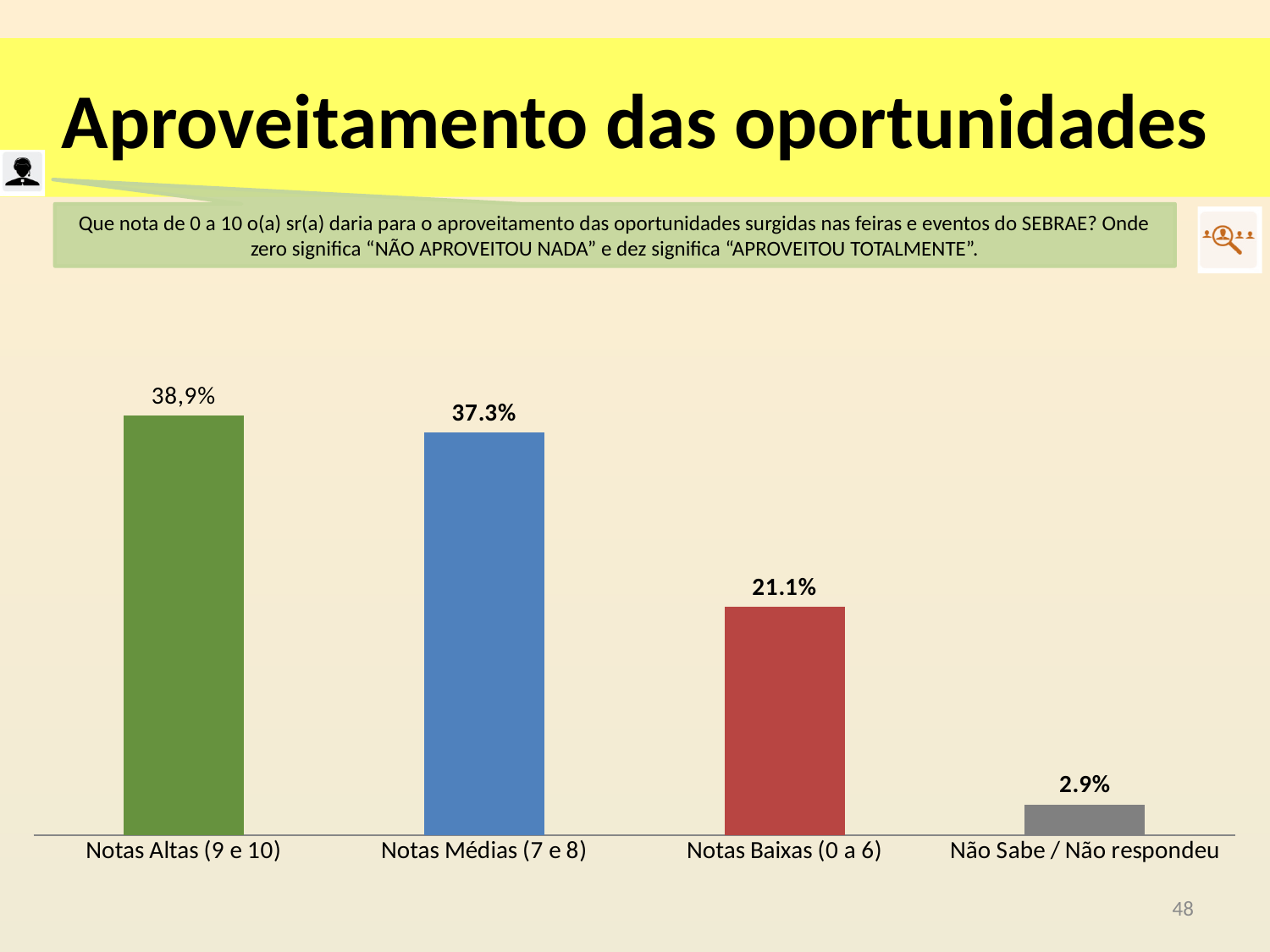
How many categories are shown in the chart? 4 What kind of chart is shown on the slide? Bar chart Which is larger, the value for Notas Altas (9 e 10) or the value for Notas Médias (7 e 8)? Notas Altas (9 e 10) What is the value for Notas Altas (9 e 10)? 38,9% What is the value for Não Sabe / Não respondeu? 2.9% What is the value for Notas Baixas (0 a 6)? 21.1% Which category has the lowest value? Não Sabe / Não respondeu What is the difference between the values for Notas Médias (7 e 8) and Notas Baixas (0 a 6)? 16.2% What is the difference between the values for Notas Baixas (0 a 6) and Não Sabe / Não respondeu? 18.2% Which category has the highest value? Notas Altas (9 e 10) What colour is the bar for Notas Baixas (0 a 6)? Red What is the value for Notas Médias (7 e 8)? 37.3%